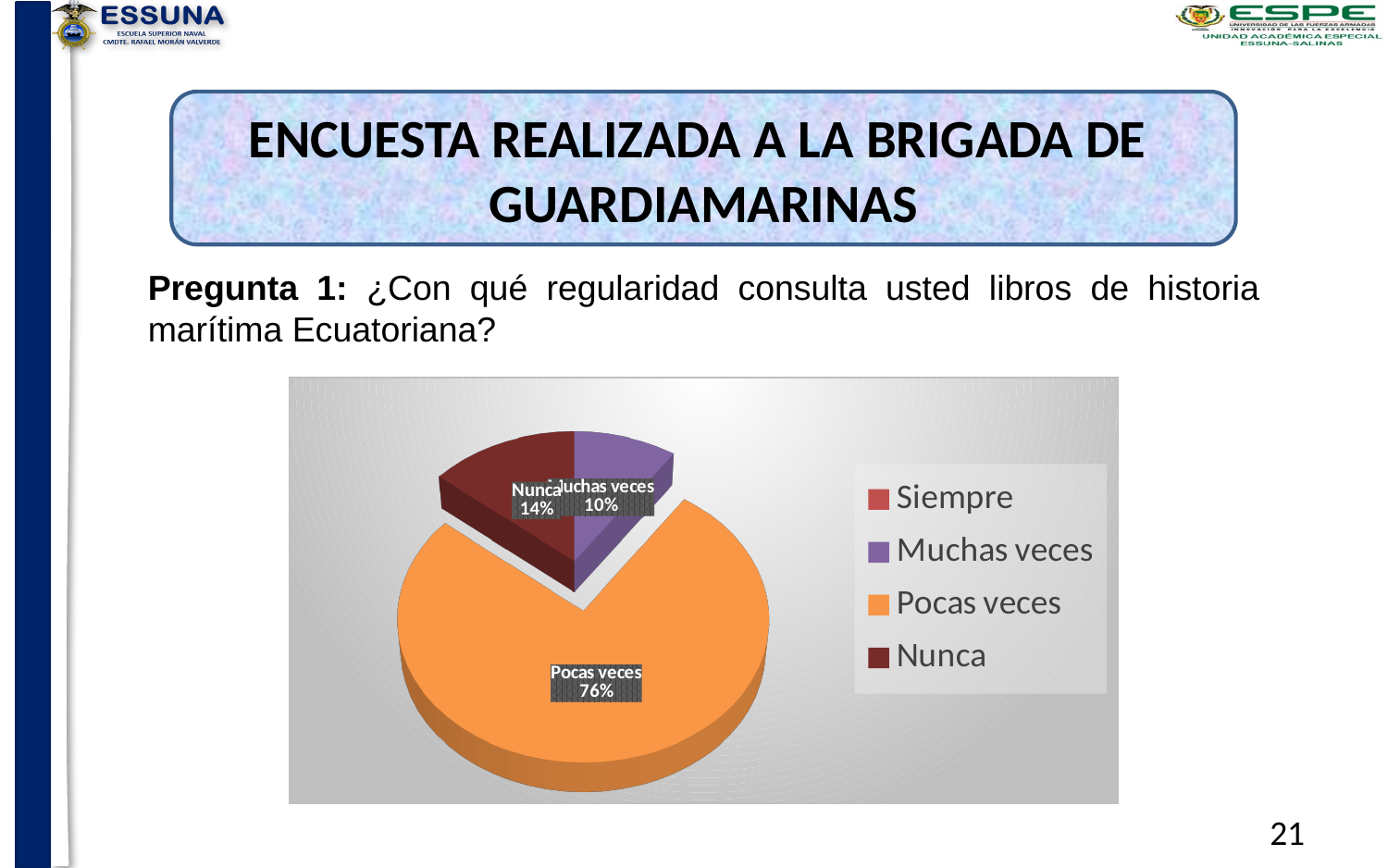
What colour is the "Pocas veces" slice? Orange What is the difference in percentage points between "Nunca" and "Muchas veces"? 4 What is the difference in percentage points between "Pocas veces" and "Nunca"? 62 What percentage is shown for "Muchas veces"? 10% Which is larger, the share for "Nunca" or the share for "Muchas veces"? Nunca Which category has the largest share of the pie? Pocas veces How many categories does the legend list? 4 What type of chart is shown on the slide? Pie chart What percentage is shown for "Pocas veces"? 76% Of the slices with printed labels, which has the smallest share? Muchas veces Which legend entry has no visible slice in the pie? Siempre What percentage is shown for "Nunca"? 14%